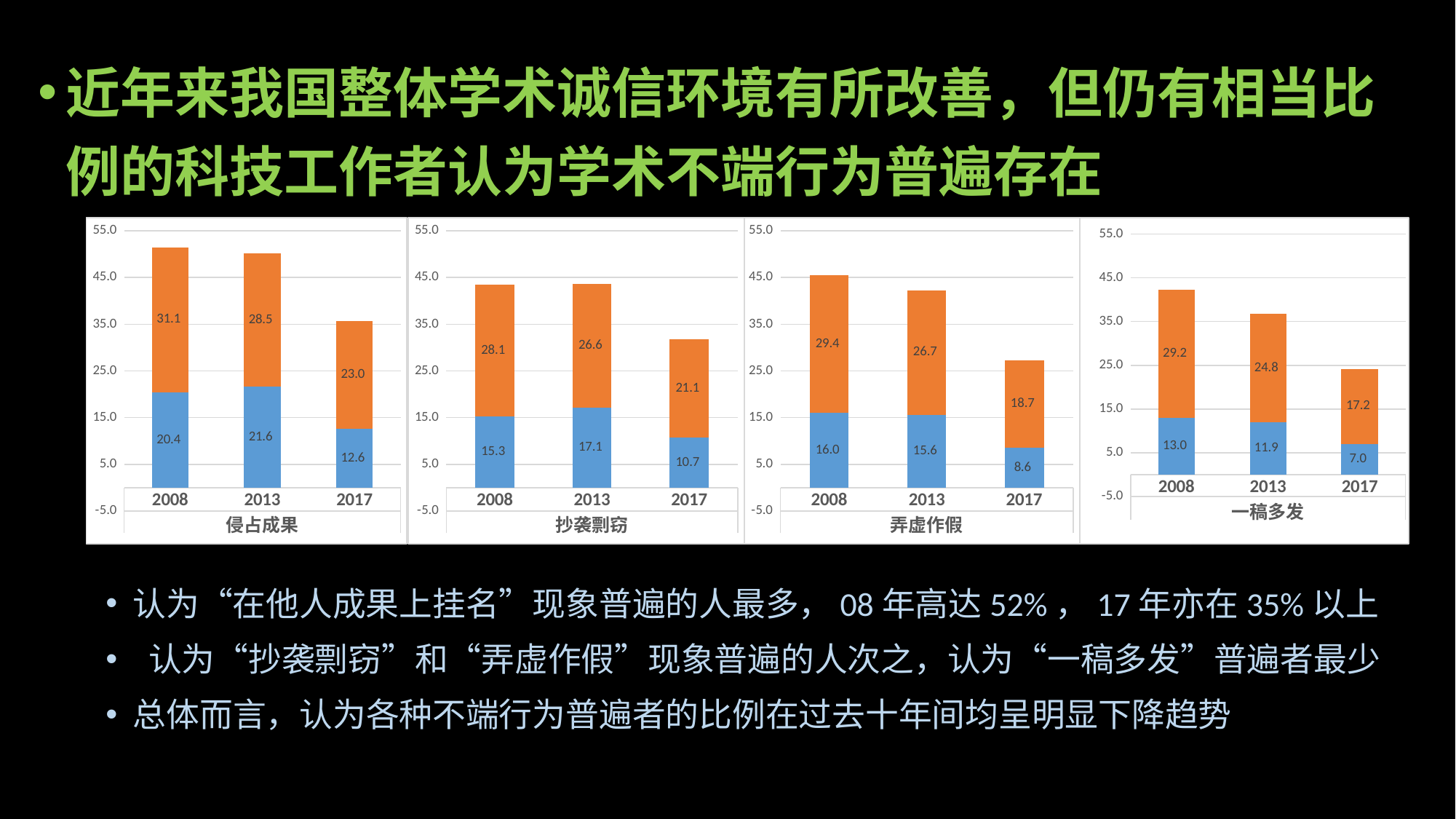
In the 弄虚作假 chart, what is the total of the stacked bar for 2017? 27.3 In the 侵占成果 chart, what is the total of the stacked bar for 2008? 51.5 In the 弄虚作假 chart, is the blue segment value for 2008 larger than the blue segment value for 2013? Yes In the 一稿多发 chart, what is the value of the blue segment for 2017? 7.0 In the 弄虚作假 chart, what is the value of the orange segment for 2017? 18.7 In the 抄袭剽窃 chart, which year has the highest orange segment value? 2008 In the 一稿多发 chart, which year has the lowest blue segment value? 2017 In the 抄袭剽窃 chart, what is the value of the blue segment for 2013? 17.1 In the 侵占成果 chart, what is the difference between the orange segment values for 2008 and 2017? 8.1 How many years are shown on the x axis of the 一稿多发 chart? 3 In the 侵占成果 chart, what is the value of the orange segment for 2008? 31.1 What type of chart is used for 抄袭剽窃? Stacked bar chart